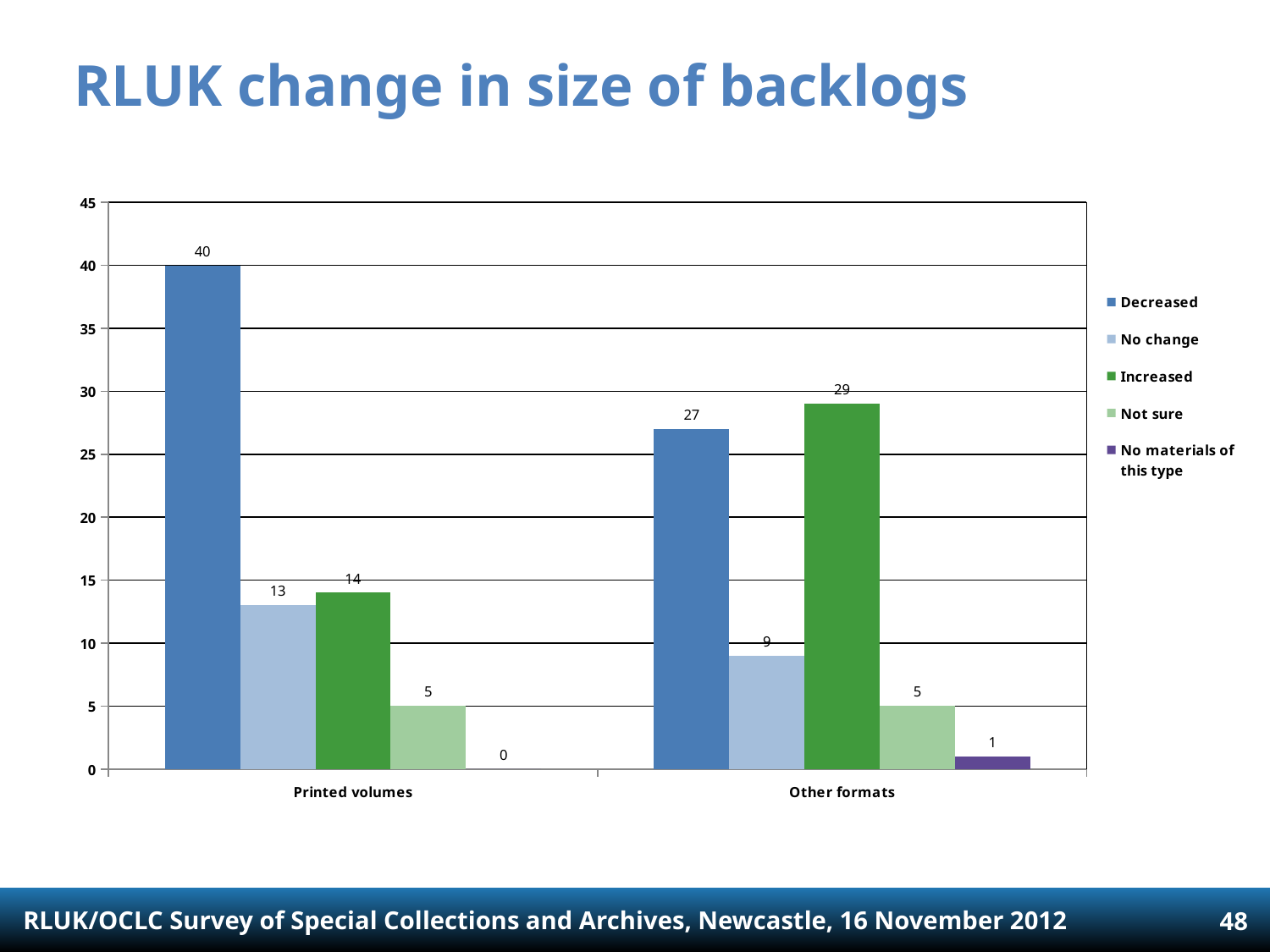
What is the difference between the Decreased values for Printed volumes and Other formats? 13 Which is larger in the Other formats category: Decreased or Increased? Increased Which series has the highest value in the Printed volumes category? Decreased What is the title of the slide? RLUK change in size of backlogs What is the value for No materials of this type in the Printed volumes category? 0 What is the value for Decreased in the Printed volumes category? 40 What is the value for No change in the Other formats category? 9 How many series does the legend list? 5 How many categories are shown on the x axis? 2 Which series has the lowest value in the Other formats category? No materials of this type What kind of chart is shown on the slide? Bar chart What is the value for Increased in the Other formats category? 29